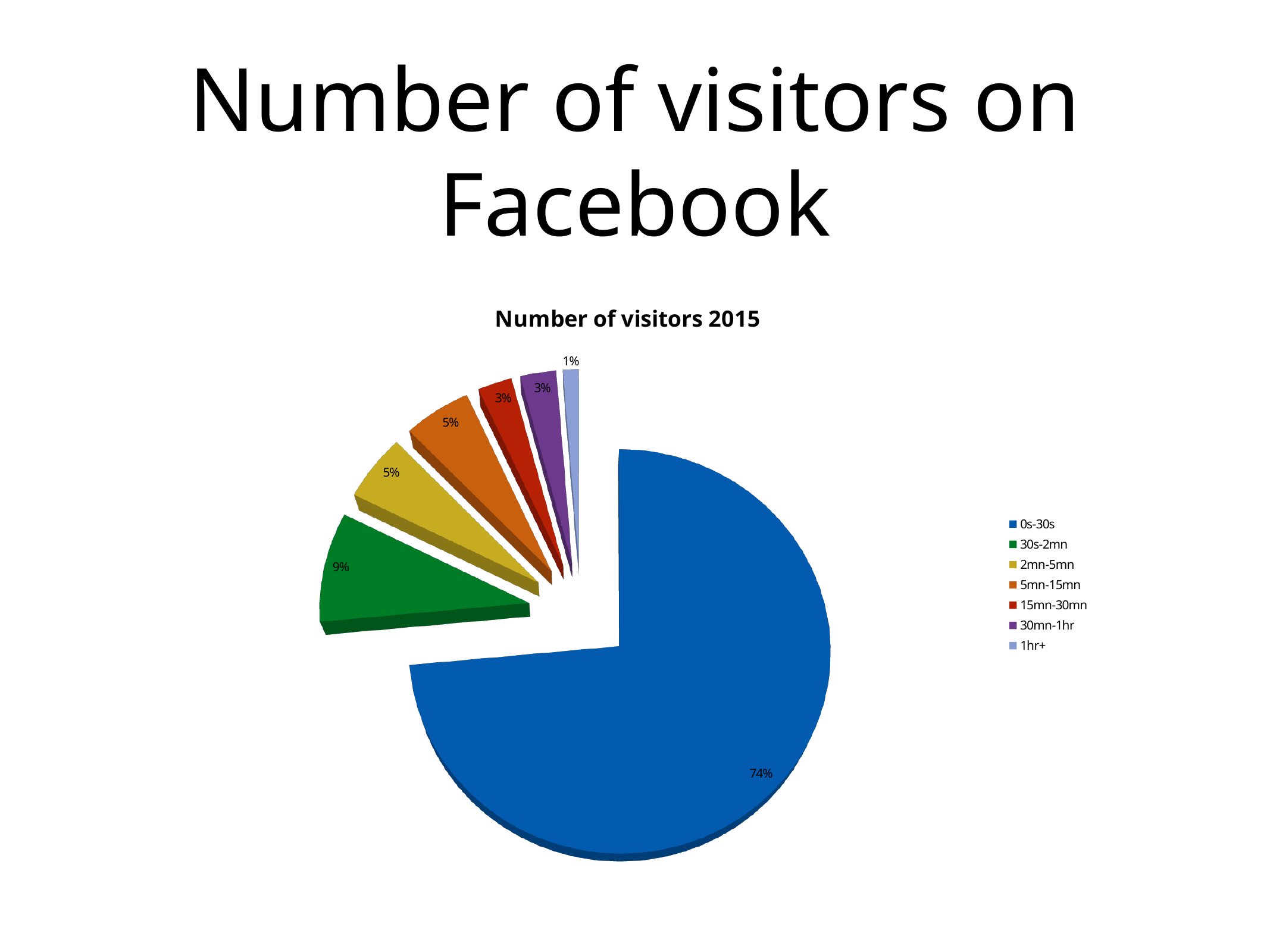
What share of the pie does the 30s-2mn slice represent? 9% What is the value shown for the 1hr+ slice? 1% Which is larger, the 30s-2mn slice or the 2mn-5mn slice? 30s-2mn What is the difference between the 0s-30s share and the 30s-2mn share? 65% Which category has the largest slice of the pie? 0s-30s Which category has the smallest slice of the pie? 1hr+ What type of chart is shown on the slide? pie chart What colour is the 0s-30s slice? blue What is the value shown for the 15mn-30mn slice? 3% How many categories does the legend list? 7 What share of the pie does the 0s-30s slice represent? 74% What is the title of the chart? Number of visitors 2015